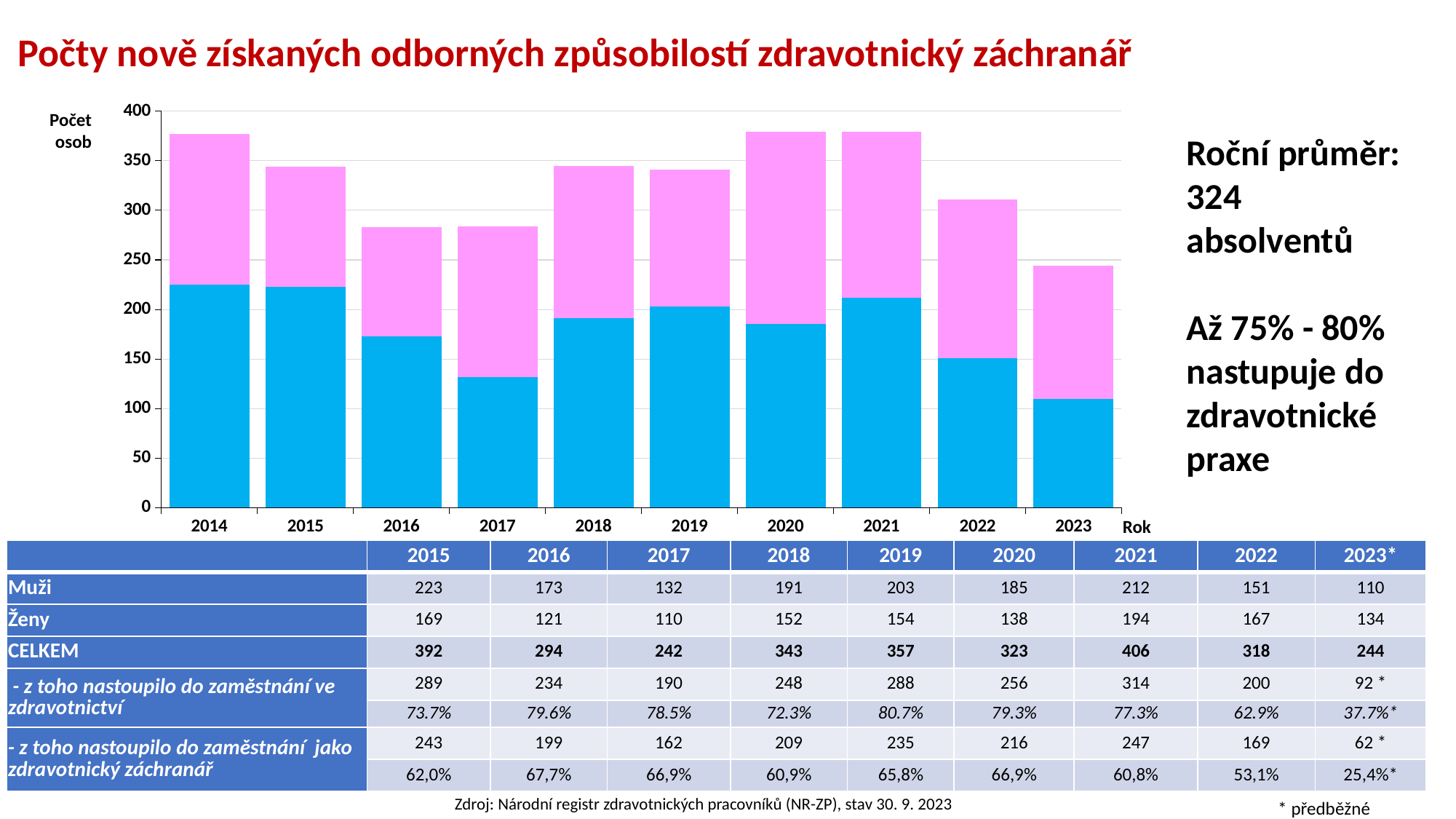
Is the total bar for 2014 greater or less than 350? greater Which year has the taller total bar, 2014 or 2023? 2014 Is the total bar for 2023 greater or less than 300? less Which year has the largest pink segment in the chart? 2020 Is the blue segment for 2017 greater or less than 150? less What kind of chart is shown on the slide? stacked bar chart How many years are shown on the x axis of the chart? 10 What is the label on the horizontal axis of the chart? Rok Which year has the lowest total bar in the chart? 2023 Do the total bars rise or fall from 2021 to 2023? fall Which year has the smallest blue segment in the chart? 2023 What is the label on the vertical axis of the chart? Počet osob